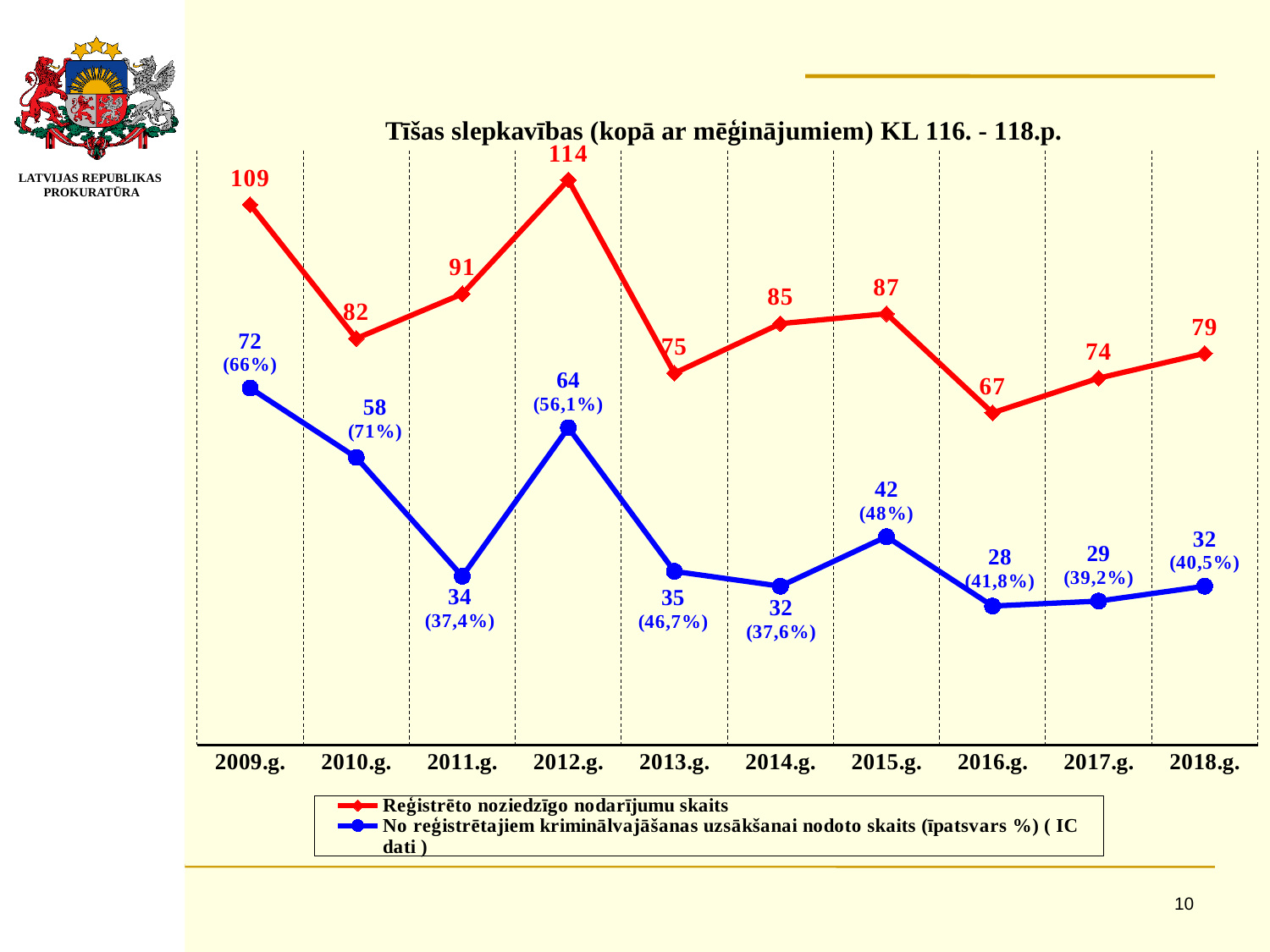
What is the value of 'No reģistrētajiem kriminālvajāšanas uzsākšanai nodoto skaits' for 2015.g.? 42 In which year is 'No reģistrētajiem kriminālvajāšanas uzsākšanai nodoto skaits' lowest? 2016.g. What is the title of the chart? Tīšas slepkavības (kopā ar mēģinājumiem) KL 116. - 118.p. What type of chart is shown on the slide? line chart What percentage is shown next to the blue series value for 2010.g.? 71% In which year is 'Reģistrēto noziedzīgo nodarījumu skaits' highest? 2012.g. How many series does the legend list? 2 What is the value of 'Reģistrēto noziedzīgo nodarījumu skaits' for 2012.g.? 114 Which is larger: 'Reģistrēto noziedzīgo nodarījumu skaits' in 2014.g. or in 2015.g.? 2015.g. What is the difference between 'Reģistrēto noziedzīgo nodarījumu skaits' in 2009.g. and 2010.g.? 27 How many years are shown on the x axis? 10 What is the value of 'Reģistrēto noziedzīgo nodarījumu skaits' for 2016.g.? 67